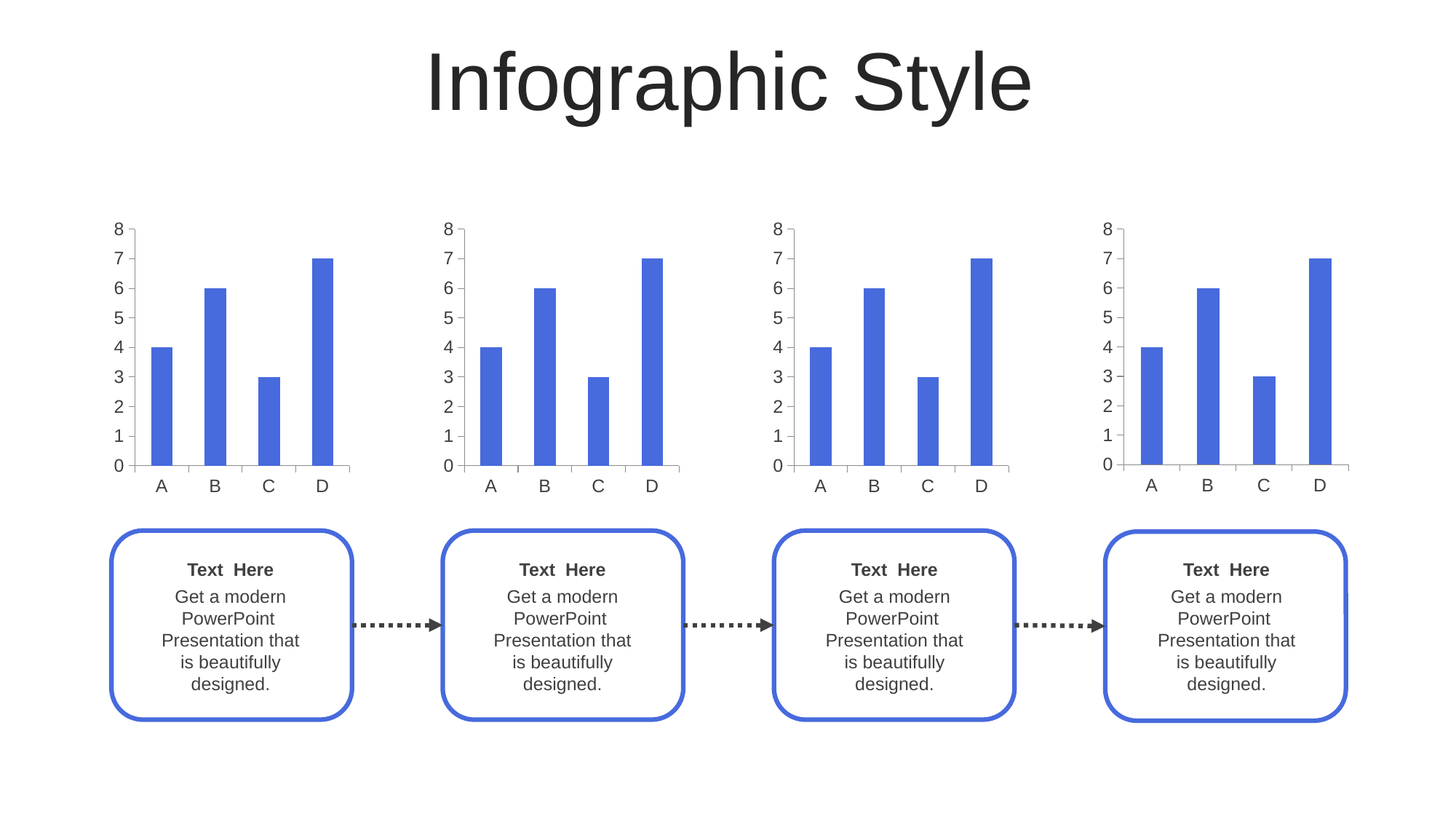
In the third chart from the left, what is the value for category C? 3 In the second chart from the left, what is the difference between the values for D and C? 4 In the leftmost chart, which category has the highest value? D In the second chart from the left, what is the value for category A? 4 What kind of chart is the leftmost chart? bar chart In the leftmost chart, is the value for B greater or less than 5? greater How many categories are shown on the x axis of the rightmost chart? 4 In the third chart from the left, which is larger, the value for A or the value for B? B How many charts are shown on the slide? 4 In the leftmost chart, what is the value for category D? 7 In the rightmost chart, what is the value for category B? 6 In the rightmost chart, which category has the lowest value? C